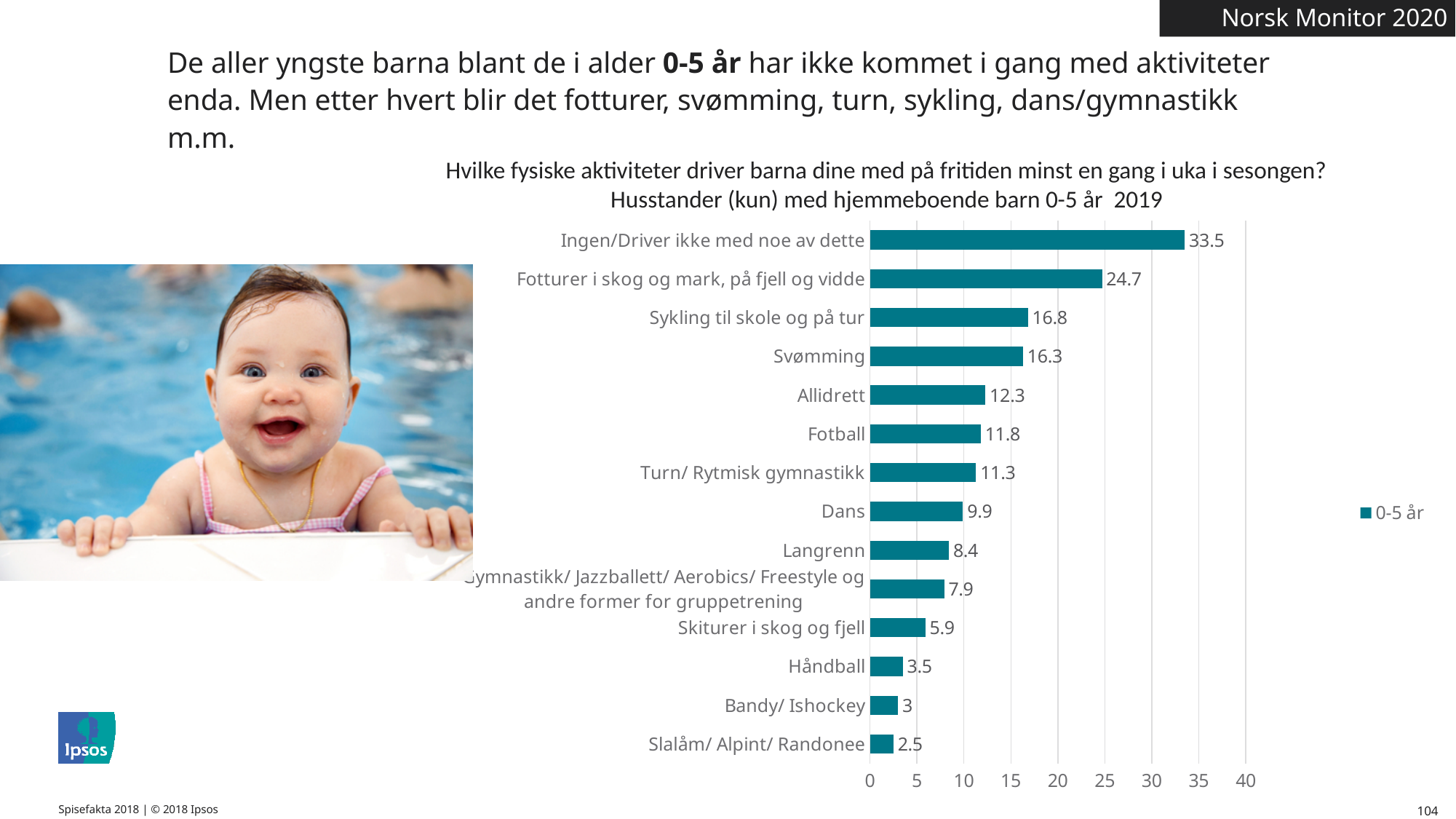
Which category has the highest value? Ingen/Driver ikke med noe av dette How many categories are shown in the chart? 14 Which is larger, the value for Allidrett or the value for Langrenn? Allidrett What is the value for Fotturer i skog og mark, på fjell og vidde? 24.7 What kind of chart is shown on the slide? bar chart What is the value for Svømming? 16.3 How many series does the legend list? 1 What is the value for Håndball? 3.5 Is the value for Sykling til skole og på tur greater or less than 15? greater What is the difference between the values for Fotball and Dans? 1.9 Which category has the lowest value? Slalåm/ Alpint/ Randonee What is the legend entry for the series shown in the chart? 0-5 år